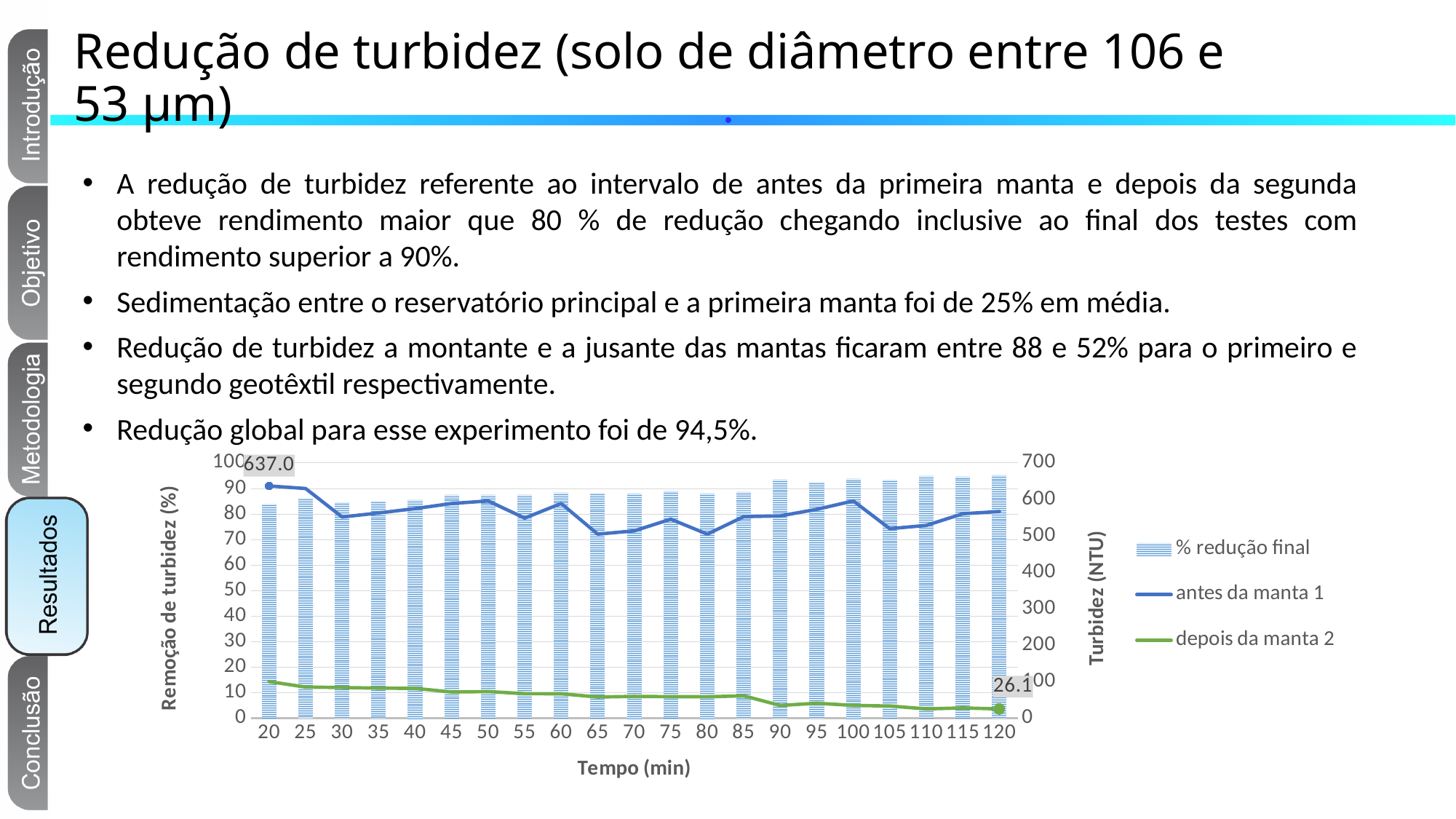
Is the 'antes da manta 1' value at 65 min greater or less than 600? less How many time points are shown on the x axis of the chart? 21 Does the 'depois da manta 2' line rise or fall from 20 min to 120 min? fall What is the value of 'depois da manta 2' at 120 min? 26.1 How many series does the chart legend list? 3 What kind of chart is shown on the slide? bar and line chart At 20 min, which series has the larger value: 'antes da manta 1' or 'depois da manta 2'? antes da manta 1 Is the 'depois da manta 2' value at 20 min greater or less than 200? less What is the difference between the labelled value of 'antes da manta 1' at 20 min and the labelled value of 'depois da manta 2' at 120 min? 610.9 What is the title of the x axis of the chart? Tempo (min) What is the value of 'antes da manta 1' at 20 min? 637.0 Is the '% redução final' value at 120 min greater or less than 90? greater